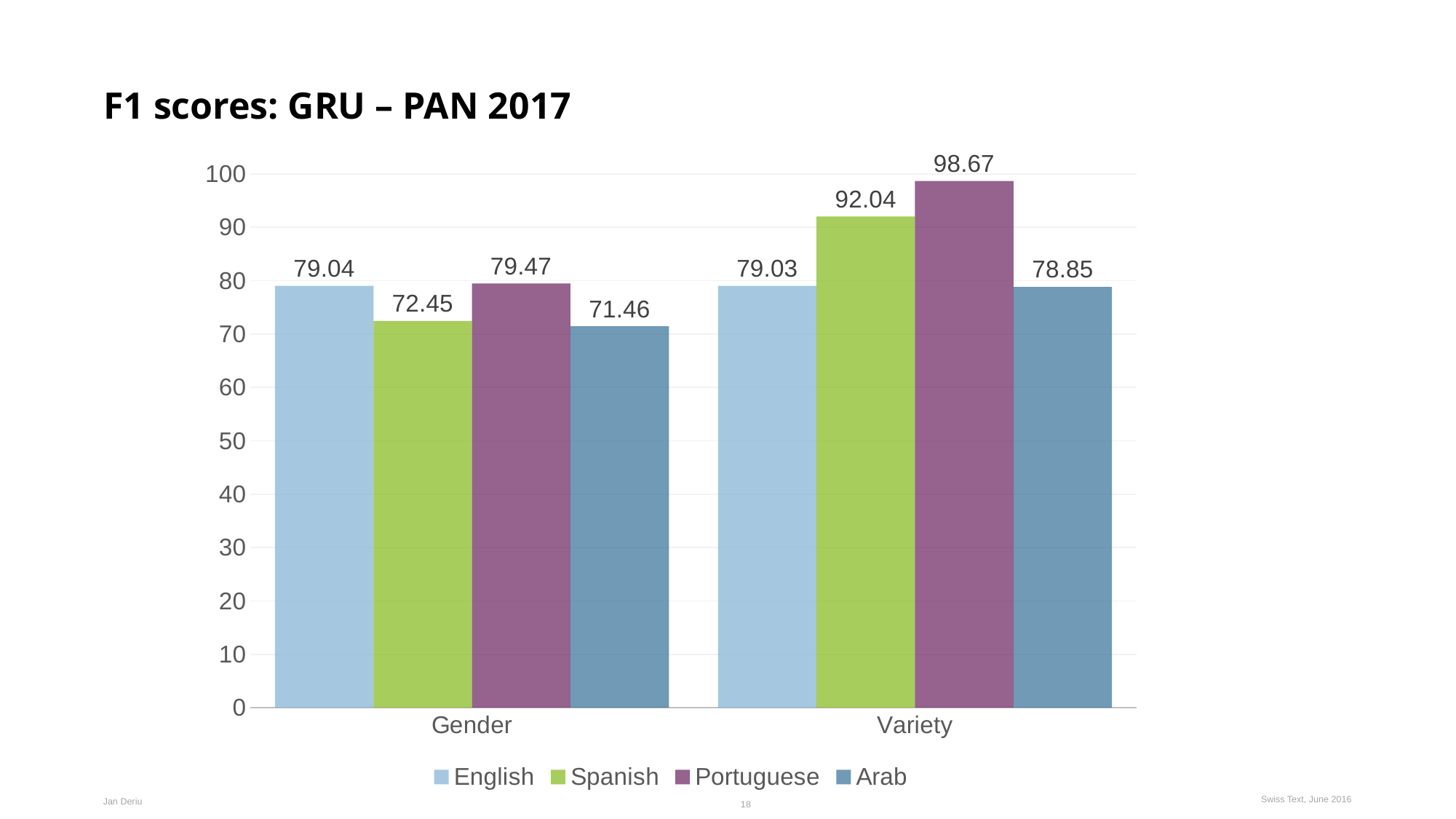
Is the Portuguese F1 score on the Variety task greater or less than 90? greater What is the F1 score for Portuguese on the Variety task? 98.67 What kind of chart is shown on the slide? Bar chart How many series does the legend list? 4 Which is larger: the Spanish F1 score on Variety or the Arab F1 score on Variety? Spanish on Variety Which language has the lowest F1 score on the Gender task? Arab What is the F1 score for Spanish on the Gender task? 72.45 What is the F1 score for Arab on the Gender task? 71.46 What is the difference between the Spanish F1 scores on Variety and Gender? 19.59 What is the title of the chart? F1 scores: GRU – PAN 2017 Which language has the highest F1 score on the Variety task? Portuguese How many task categories are shown on the x axis? 2